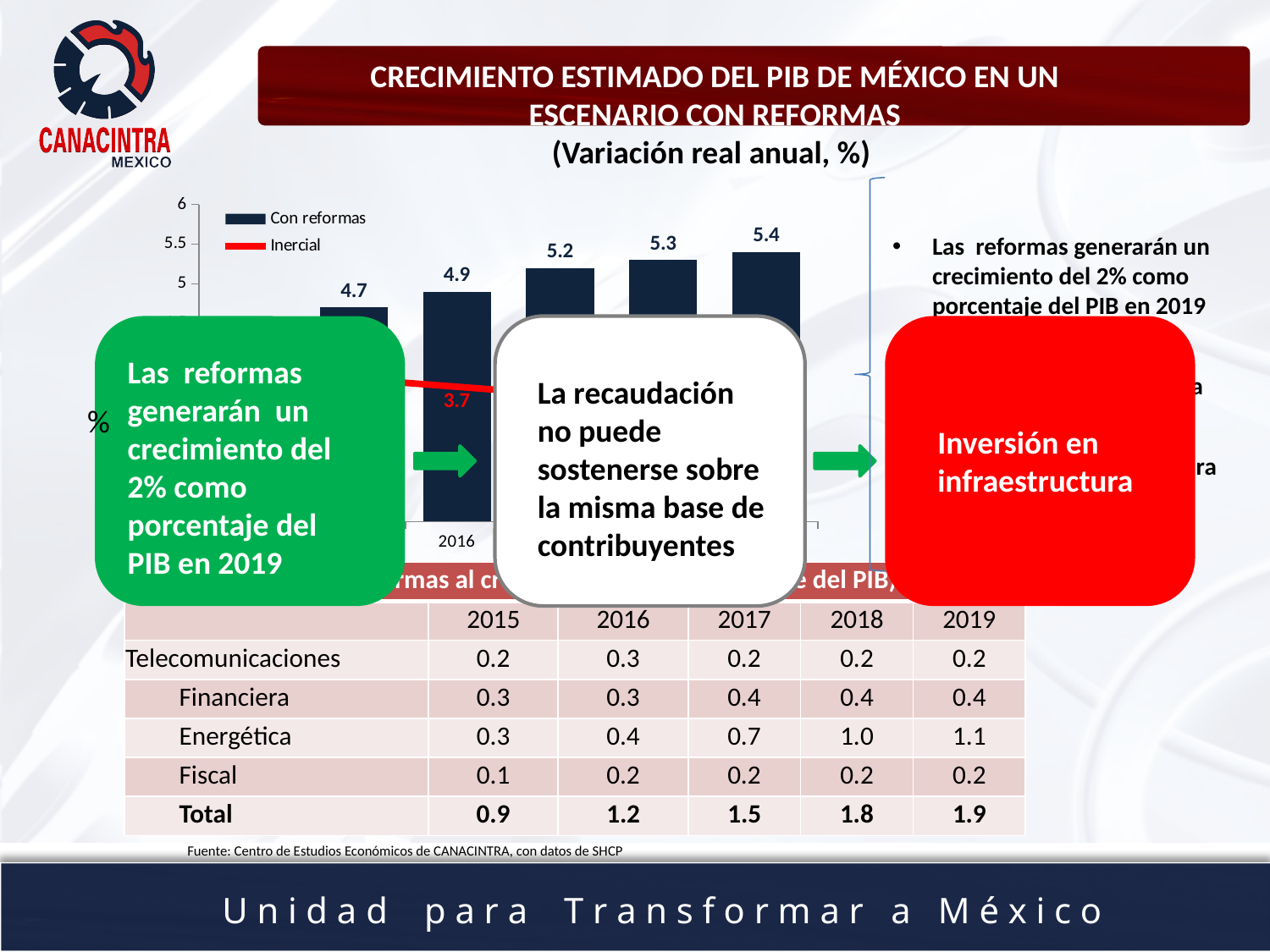
Is the highest 'Con reformas' bar greater or less than 5? greater What is the subtitle shown under the chart title? (Variación real anual, %) Which series are listed in the chart legend? Con reformas and Inercial What is the difference between the highest and lowest 'Con reformas' values? 0.7 What is the lowest value shown for the 'Con reformas' series? 4.7 What is the only 'Inercial' value printed as a data label on the chart? 3.7 What is the highest value shown for the 'Con reformas' series? 5.4 Do the 'Con reformas' values rise or fall from left to right along the x axis? Rise What is the 'Con reformas' value for 2016? 4.9 How many bars are plotted for the 'Con reformas' series? 5 What kind of chart is used to show the 'Con reformas' values? Bar chart How many series does the chart legend list? 2